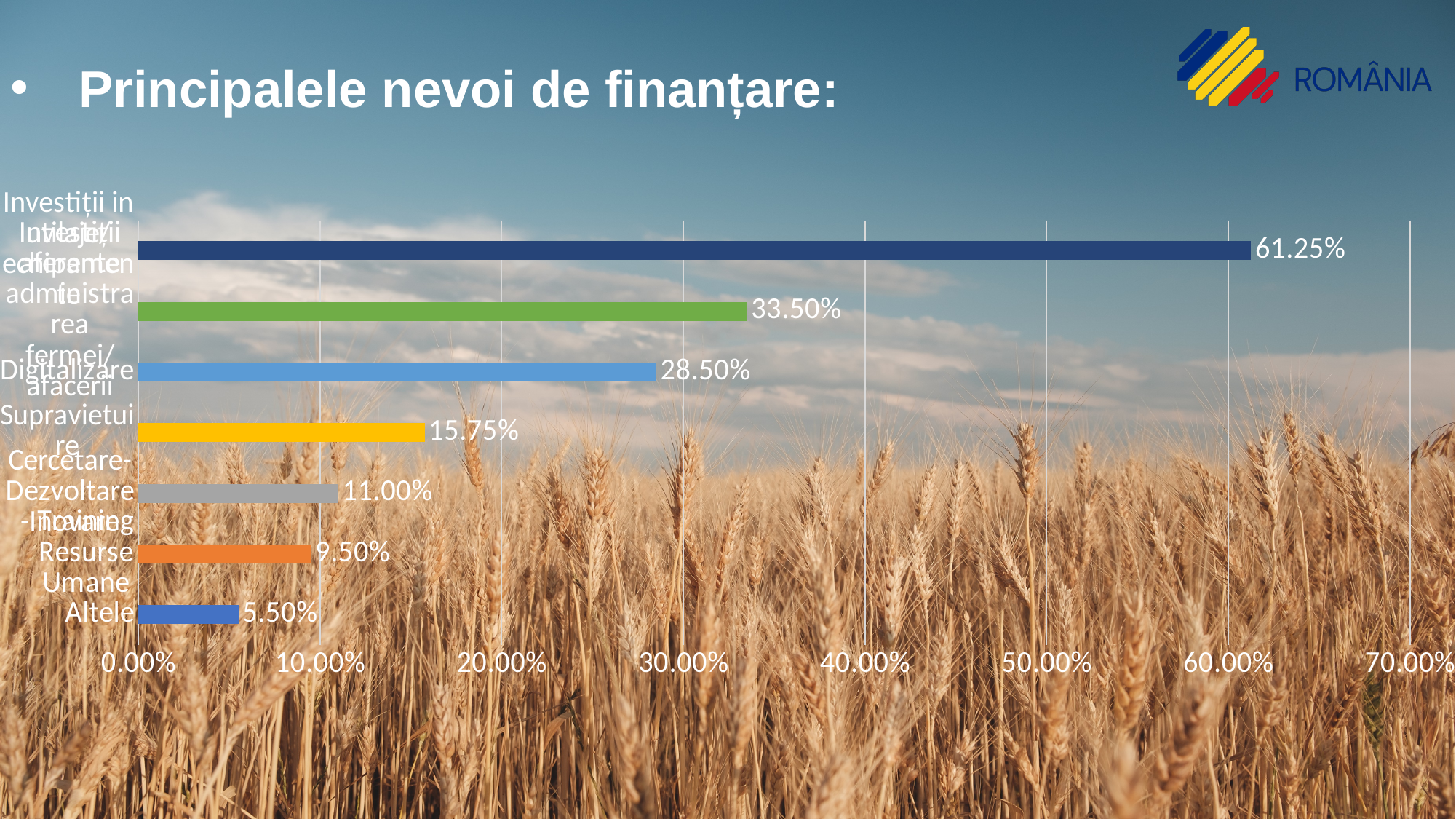
What kind of chart is shown on the slide? bar chart Which category has the lowest value? Altele Which is larger, the value for Training Resurse Umane or the value for Altele? Training Resurse Umane What is the value for Training Resurse Umane? 9.50% What is the value for Altele? 5.50% What is the value of the longest (top) bar in the chart? 61.25% What is the difference between the values for Digitalizare and Supravietuire? 12.75% What is the value for Digitalizare? 28.50% What is the value for Cercetare-Dezvoltare-Inovare? 11.00% What is the title of the slide containing the chart? Principalele nevoi de finanțare: How many bars (categories) does the chart show? 7 What is the value for Supravietuire? 15.75%